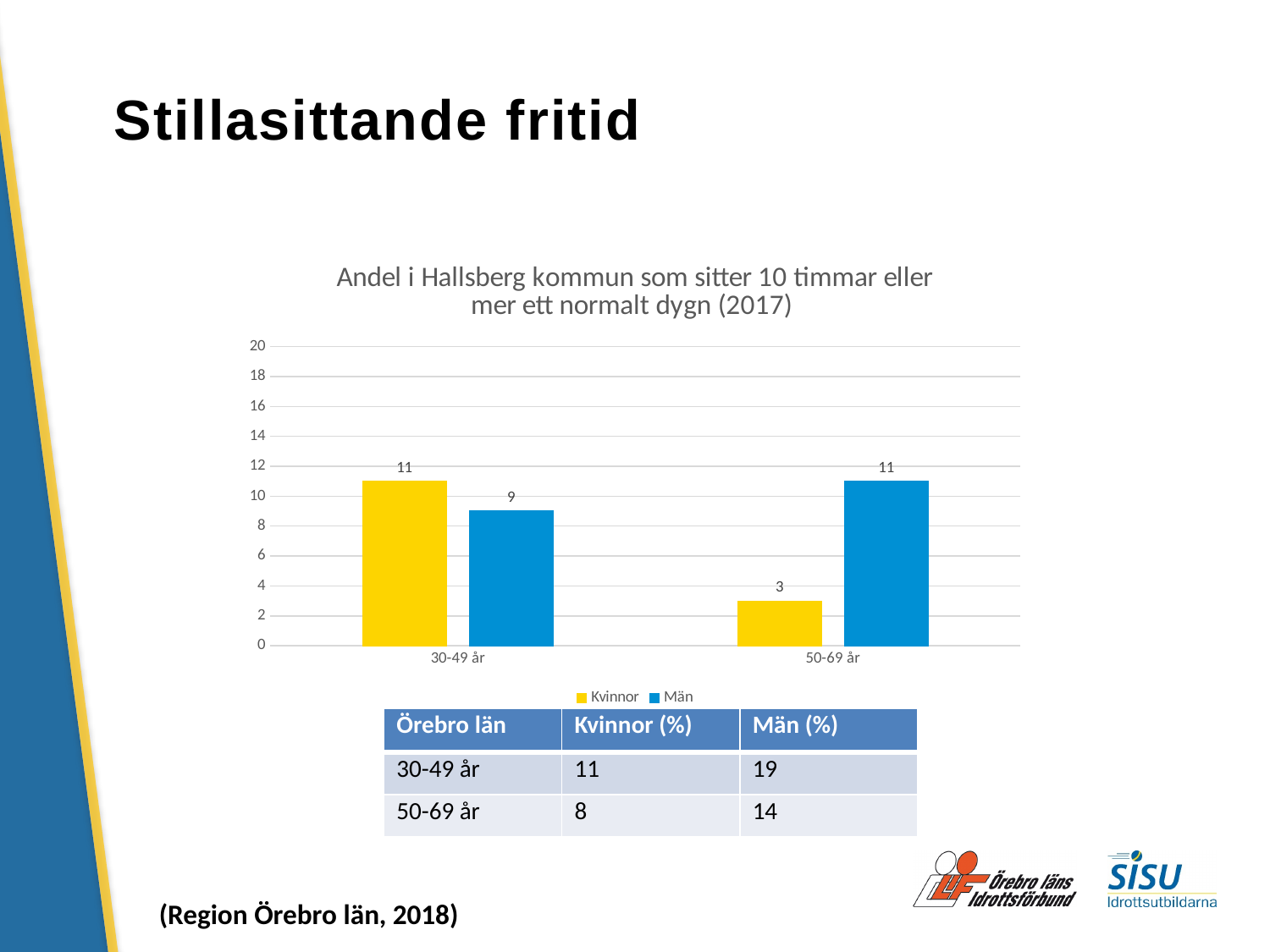
How many age categories are shown on the x axis of the chart? 2 What is the value for Kvinnor in the 50-69 år category? 3 What type of chart is shown on the slide? Bar chart How many series does the chart legend list? 2 What is the value for Kvinnor in the 30-49 år category? 11 Which age category has the highest value for Män? 50-69 år What is the value for Män in the 50-69 år category? 11 What is the value for Män in the 30-49 år category? 9 Which age category has the lowest value for Kvinnor? 50-69 år What is the difference between the Kvinnor and Män values in the 50-69 år category? 8 What is the difference between the Kvinnor and Män values in the 30-49 år category? 2 In the 30-49 år category, which is larger, Kvinnor or Män? Kvinnor